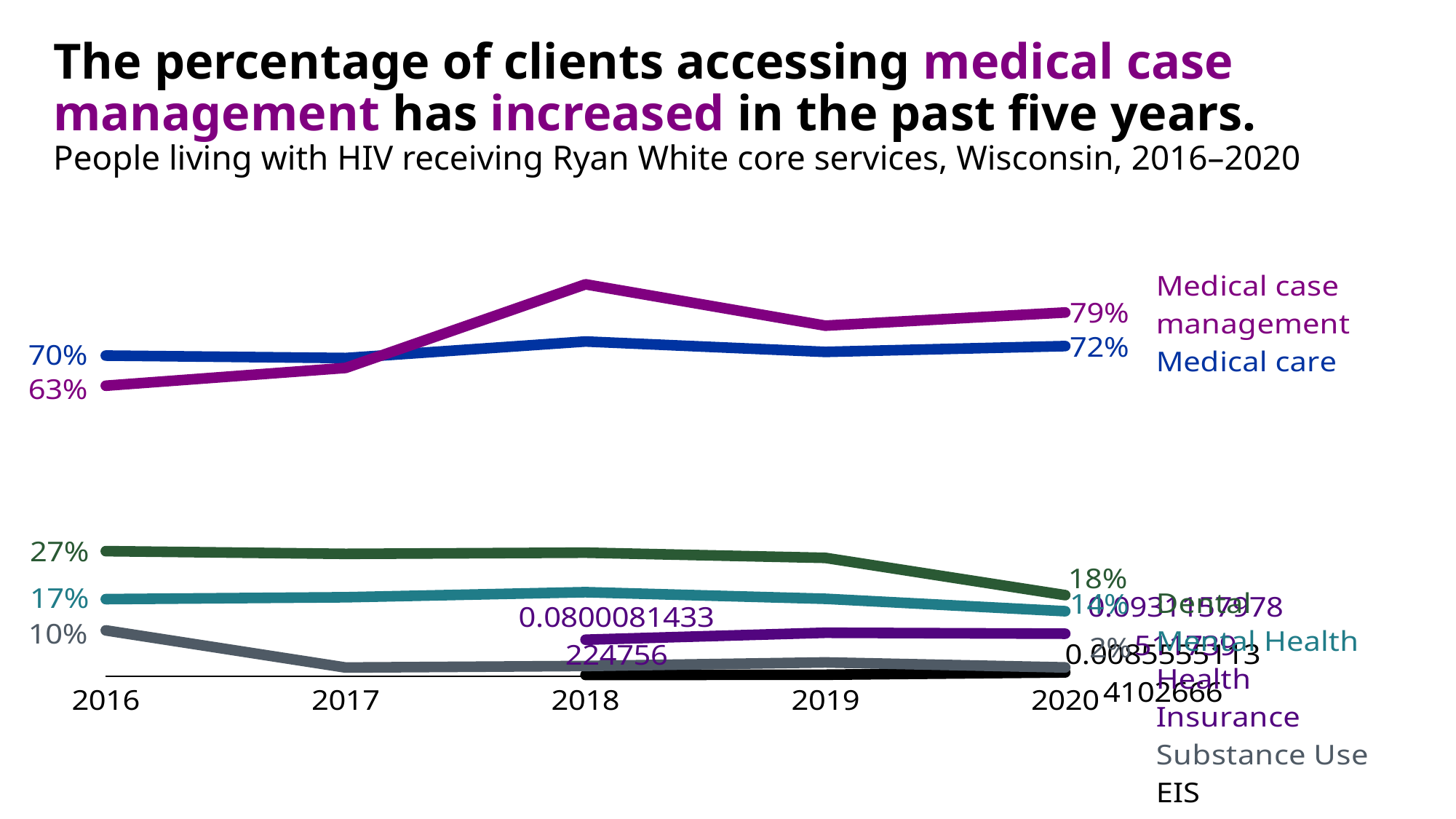
Which service had the highest percentage of clients in 2016? Medical care What percentage of clients accessed medical case management in 2020? 79% By how many percentage points did Dental fall from 2016 (27%) to 2020 (18%)? 9 percentage points What kind of chart is shown on the slide? line chart In 2020, which was higher: medical case management or medical care? Medical case management By how many percentage points did medical case management change from 2016 to 2020? 16 percentage points What was the value for Substance Use in 2016? 10% What percentage of clients accessed medical care in 2020? 72% What was the value for Dental in 2016? 27% What percentage of clients accessed medical care in 2016? 70% What percentage of clients accessed medical case management in 2016? 63% How many years are shown on the x axis? 5